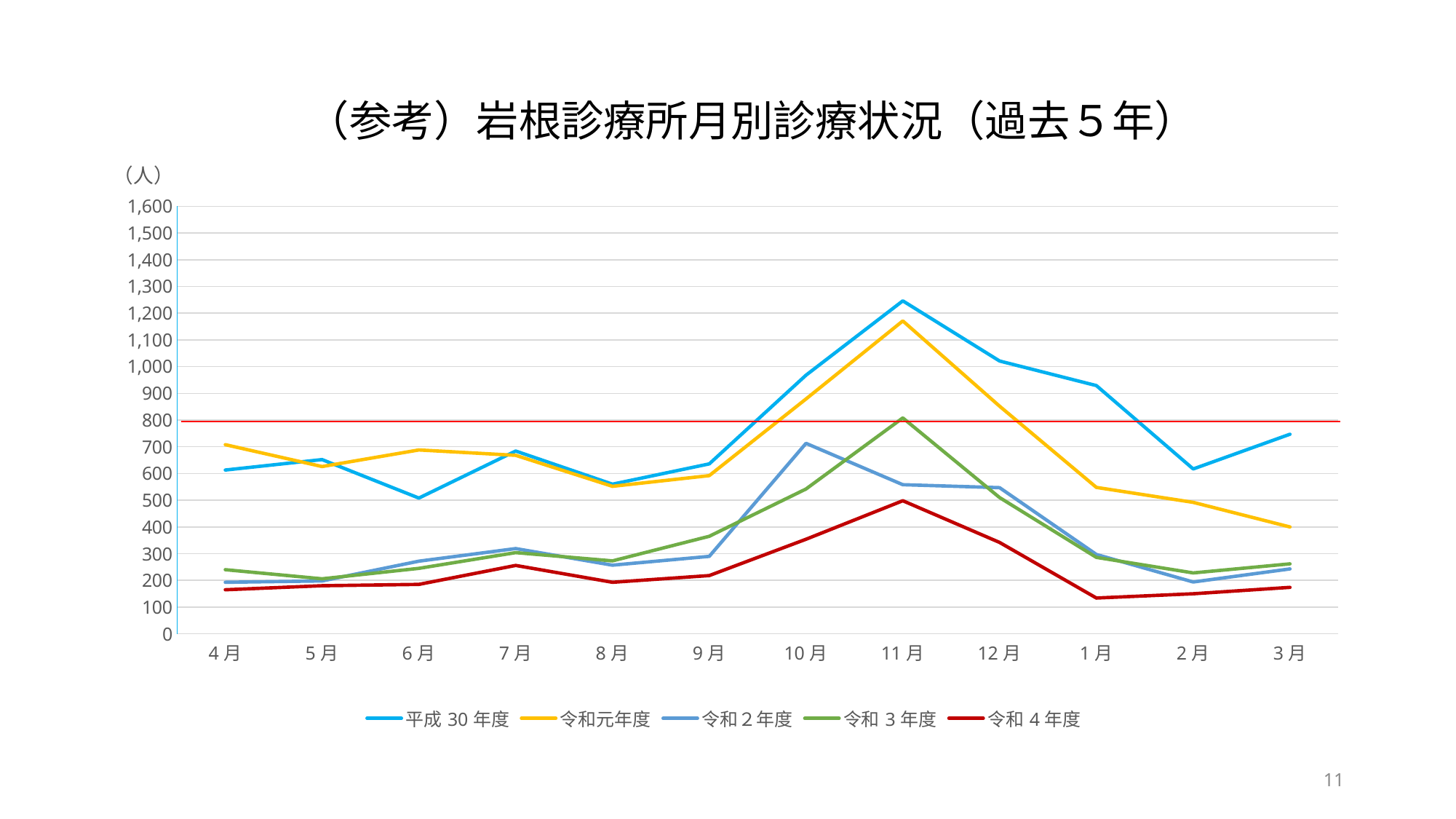
Does the 令和元年度 series rise or fall from 11月 to 3月? fall At what value on the y axis is the horizontal red reference line drawn? 800 How many months are shown along the x axis? 12 In which month is the 平成30年度 series at its lowest? 6月 In which month does the 平成30年度 series reach its highest value? 11月 In which month is the 令和4年度 series at its lowest? 1月 Is the value for 令和4年度 in 11月 greater or less than 400? greater In which month does the 令和2年度 series reach its highest value? 10月 In 10月, which series has the larger value, 令和2年度 or 令和3年度? 令和2年度 How many series does the legend list? 5 What kind of chart is shown on the slide? line chart Is the value for 平成30年度 in 11月 greater or less than 1,100? greater